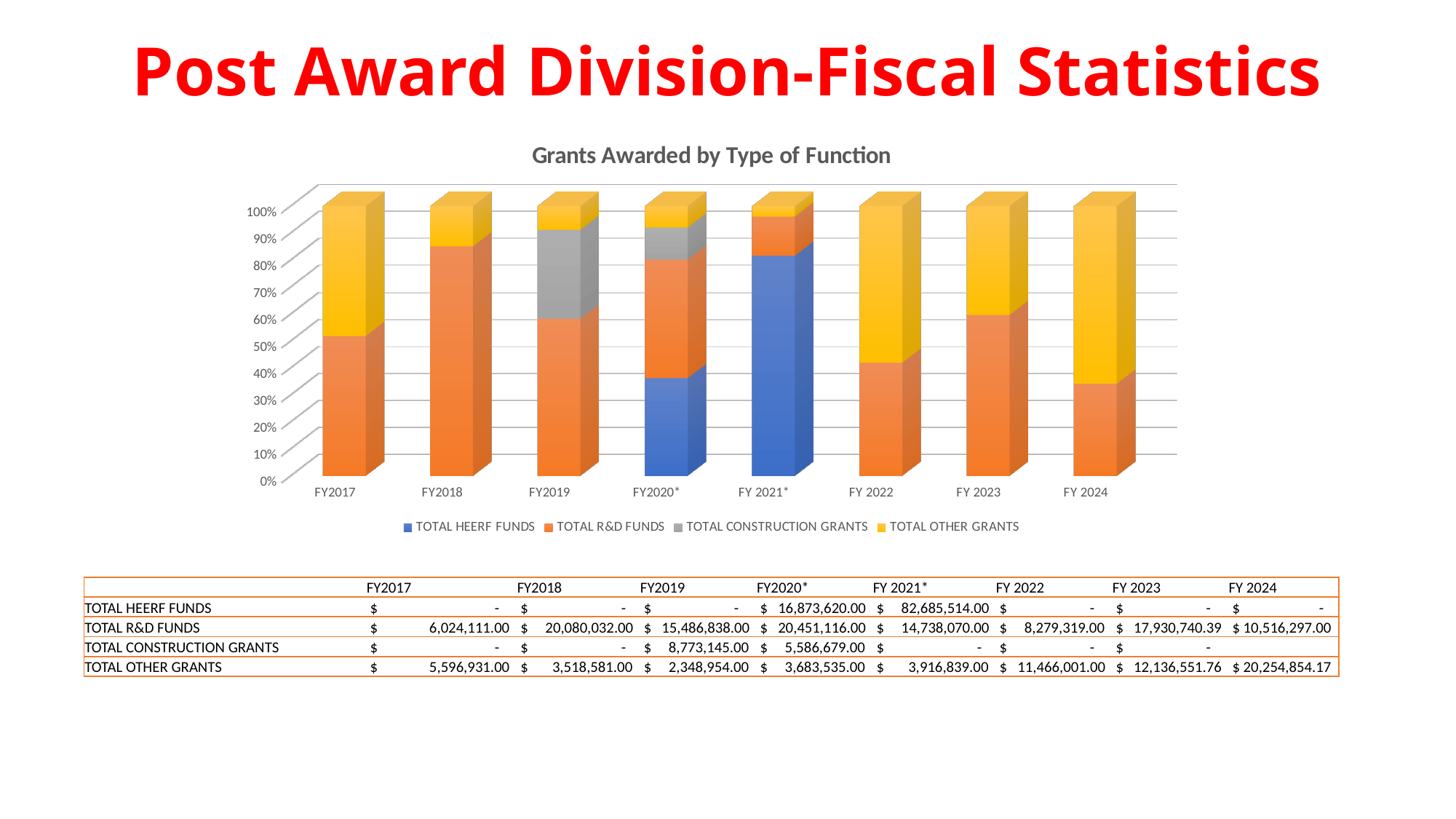
What type of chart is 'Grants Awarded by Type of Function'? Stacked bar chart Which colour represents TOTAL HEERF FUNDS in the 'Grants Awarded by Type of Function' chart? Blue How many series does the legend of the 'Grants Awarded by Type of Function' chart list? 4 In FY 2022, which is larger: TOTAL R&D FUNDS or TOTAL OTHER GRANTS? TOTAL OTHER GRANTS What is the value of TOTAL HEERF FUNDS for FY 2021*? $ 82,685,514.00 How many fiscal years are shown on the x axis of the 'Grants Awarded by Type of Function' chart? 8 What is the value of TOTAL R&D FUNDS for FY2018? $ 20,080,032.00 Which fiscal year has the lowest value for TOTAL R&D FUNDS? FY2017 In the 'Grants Awarded by Type of Function' chart, is the TOTAL R&D FUNDS share for FY2018 greater or less than 80%? greater Which fiscal year has the highest value for TOTAL OTHER GRANTS? FY 2024 What is the difference between TOTAL R&D FUNDS in FY2018 and FY2017? $ 14,055,921.00 What is the value of TOTAL CONSTRUCTION GRANTS for FY2019? $ 8,773,145.00